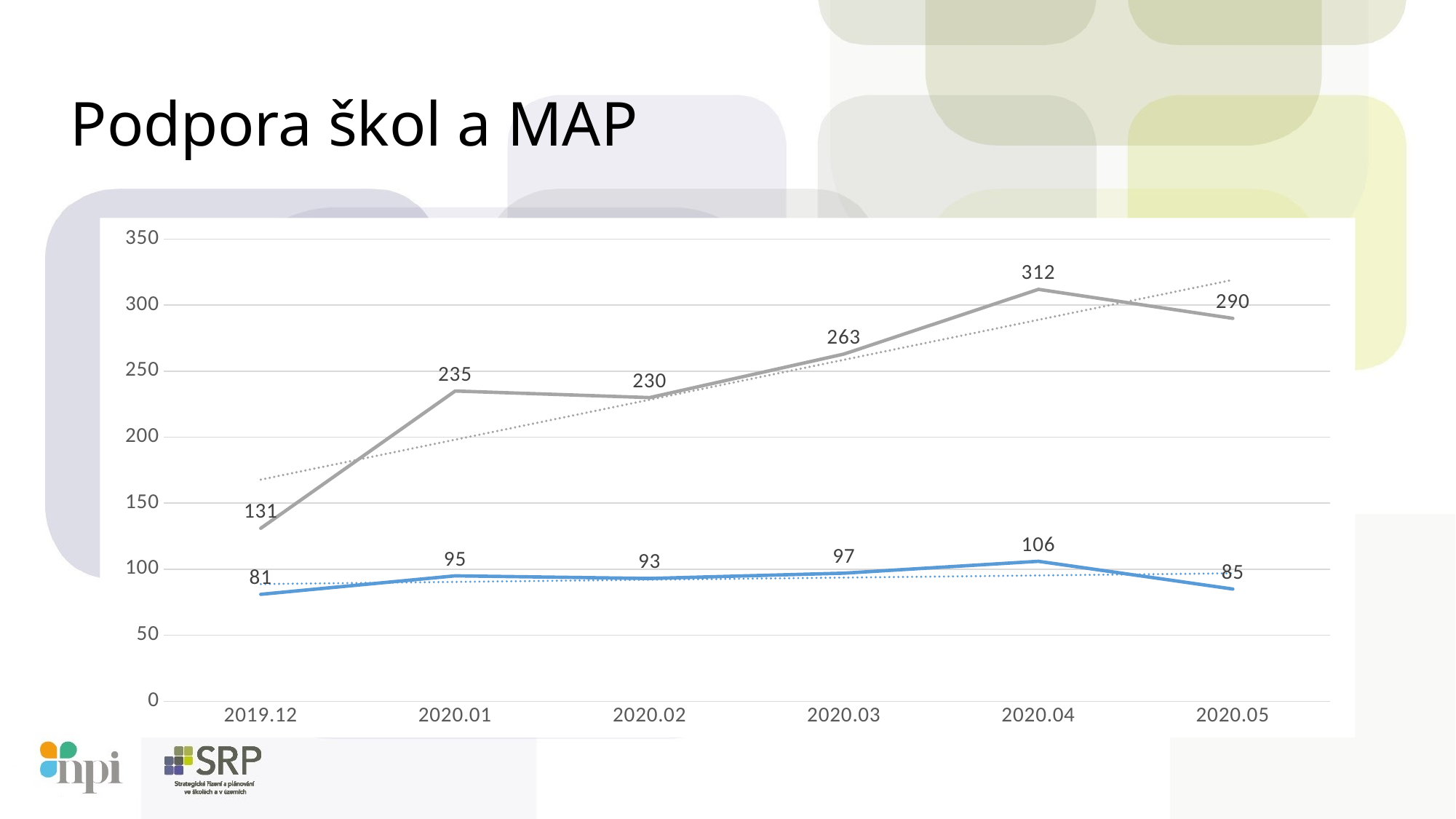
Which is larger for the blue line: the value at 2020.01 or at 2020.02? 2020.01 At which time point does the gray line reach its highest value? 2020.04 What is the value of the blue line at 2019.12? 81 Does the gray line rise or fall between 2019.12 and 2020.04? rise What is the difference between the gray line's values at 2020.04 and 2020.05? 22 What is the title of the slide containing the chart? Podpora škol a MAP How many time points are plotted along the x axis? 6 What is the value of the gray line at 2020.02? 230 What type of chart is shown on the slide? line chart What is the value of the gray line at 2020.04? 312 At which time point does the blue line have its lowest value? 2019.12 What is the value of the blue line at 2020.05? 85